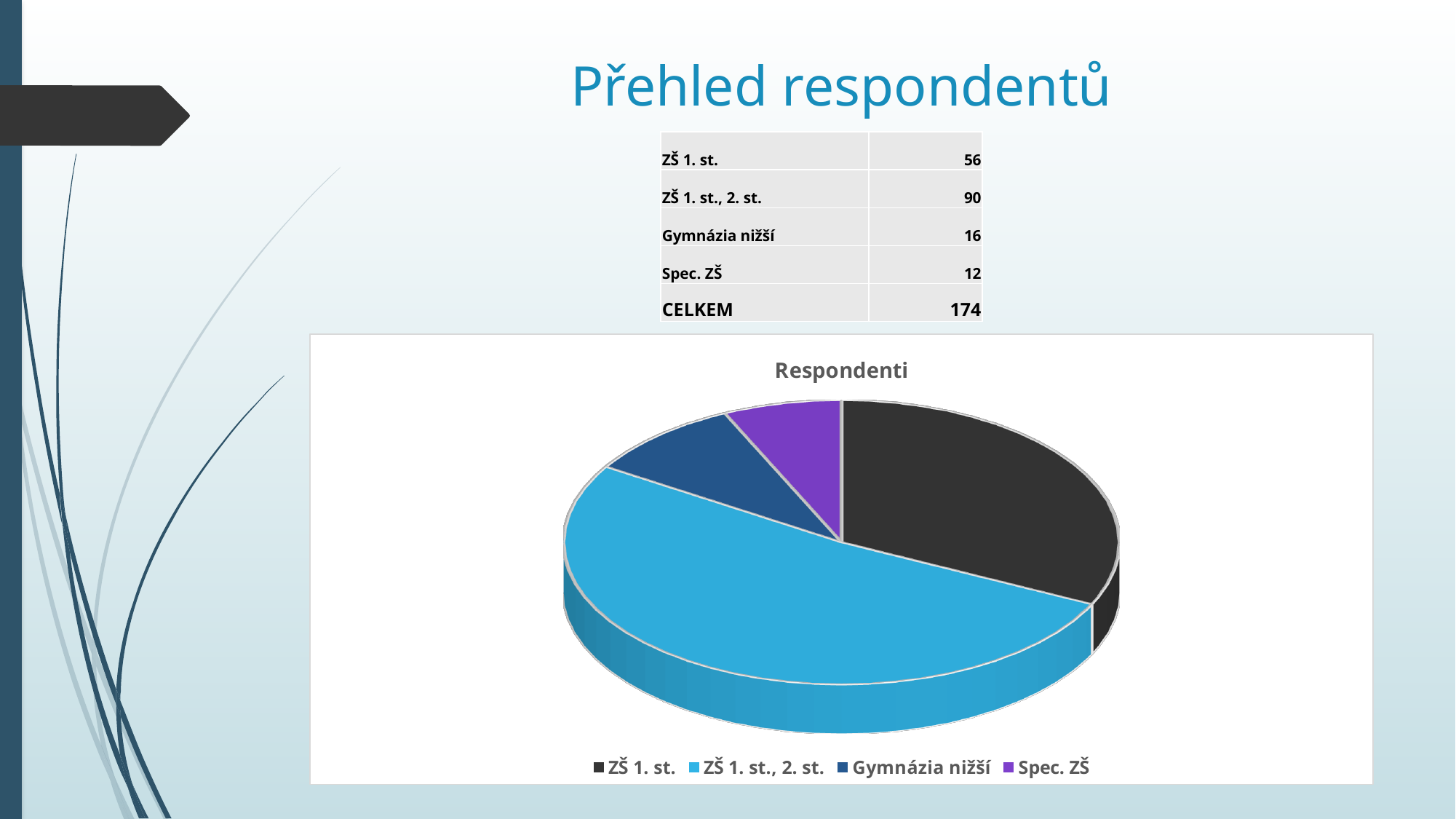
Which category has the largest slice of the pie chart? ZŠ 1. st., 2. st. Which category has the smallest slice of the pie chart? Spec. ZŠ Using the values in the table, what is the difference between ZŠ 1. st., 2. st. and ZŠ 1. st.? 34 What is the total number of respondents (CELKEM) shown in the table? 174 What is the title of the chart? Respondenti According to the table on the slide, how many respondents are in the category Gymnázia nižší? 16 Which category is larger, ZŠ 1. st. or Gymnázia nižší? ZŠ 1. st. How many entries does the chart legend list? 4 According to the table on the slide, how many respondents are in the category Spec. ZŠ? 12 According to the table on the slide, how many respondents are in the category ZŠ 1. st., 2. st.? 90 How many categories does the pie chart have? 4 What type of chart is shown on the slide? pie chart